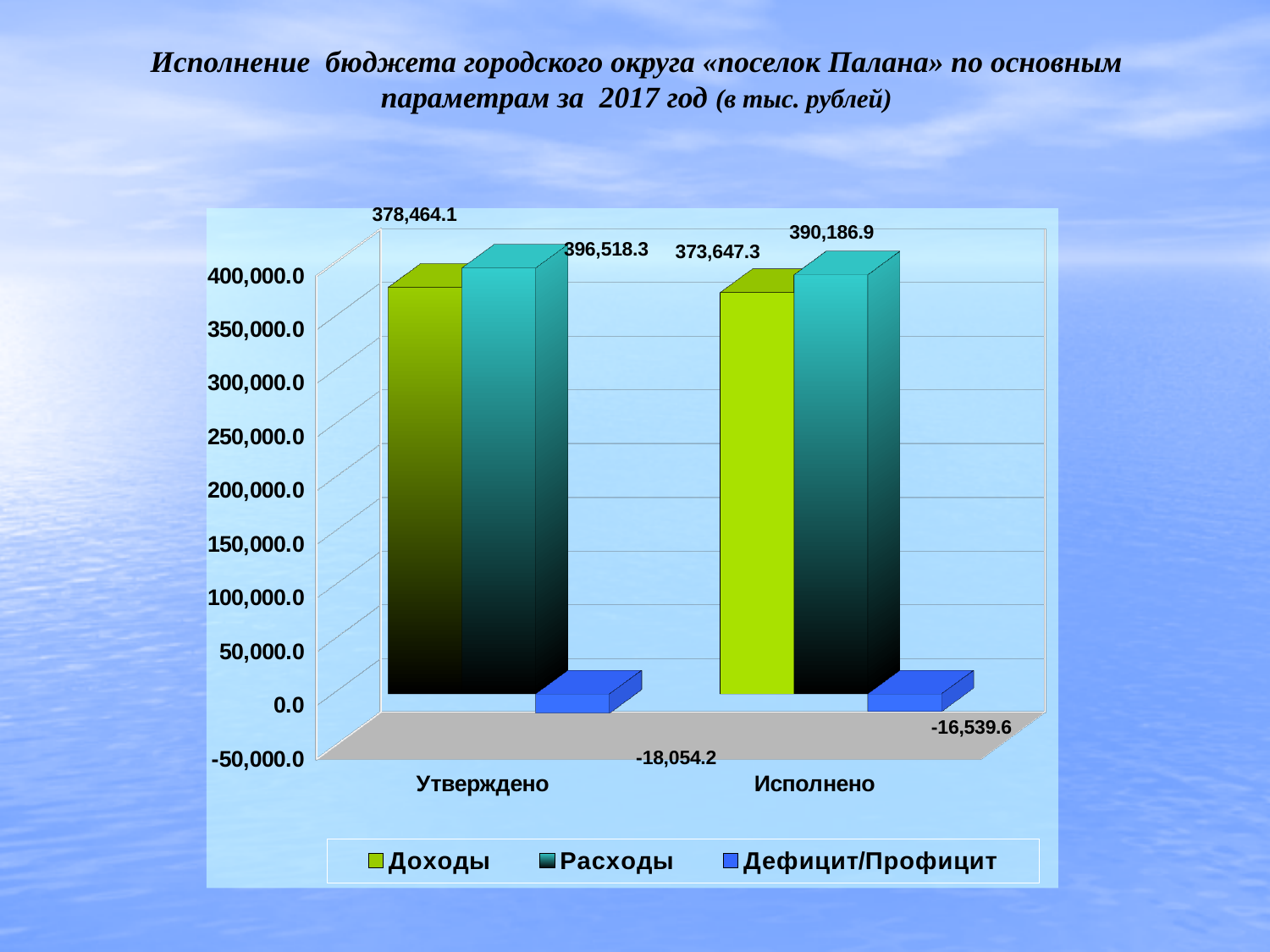
What is the value of Дефицит/Профицит for Исполнено? -16,539.6 What is the value of Дефицит/Профицит for Утверждено? -18,054.2 What is the value of Доходы for Утверждено? 378,464.1 What is the difference between Доходы for Утверждено and Доходы for Исполнено? 4,816.8 What is the difference between Расходы and Доходы for Утверждено? 18,054.2 Which series is shown in blue in the legend? Дефицит/Профицит What kind of chart is shown on the slide? Bar chart Which series has the highest value in the Исполнено category? Расходы How many series does the legend list? 3 How many categories are shown on the x axis? 2 What is the value of Расходы for Исполнено? 390,186.9 Which category has the higher value for Расходы, Утверждено or Исполнено? Утверждено